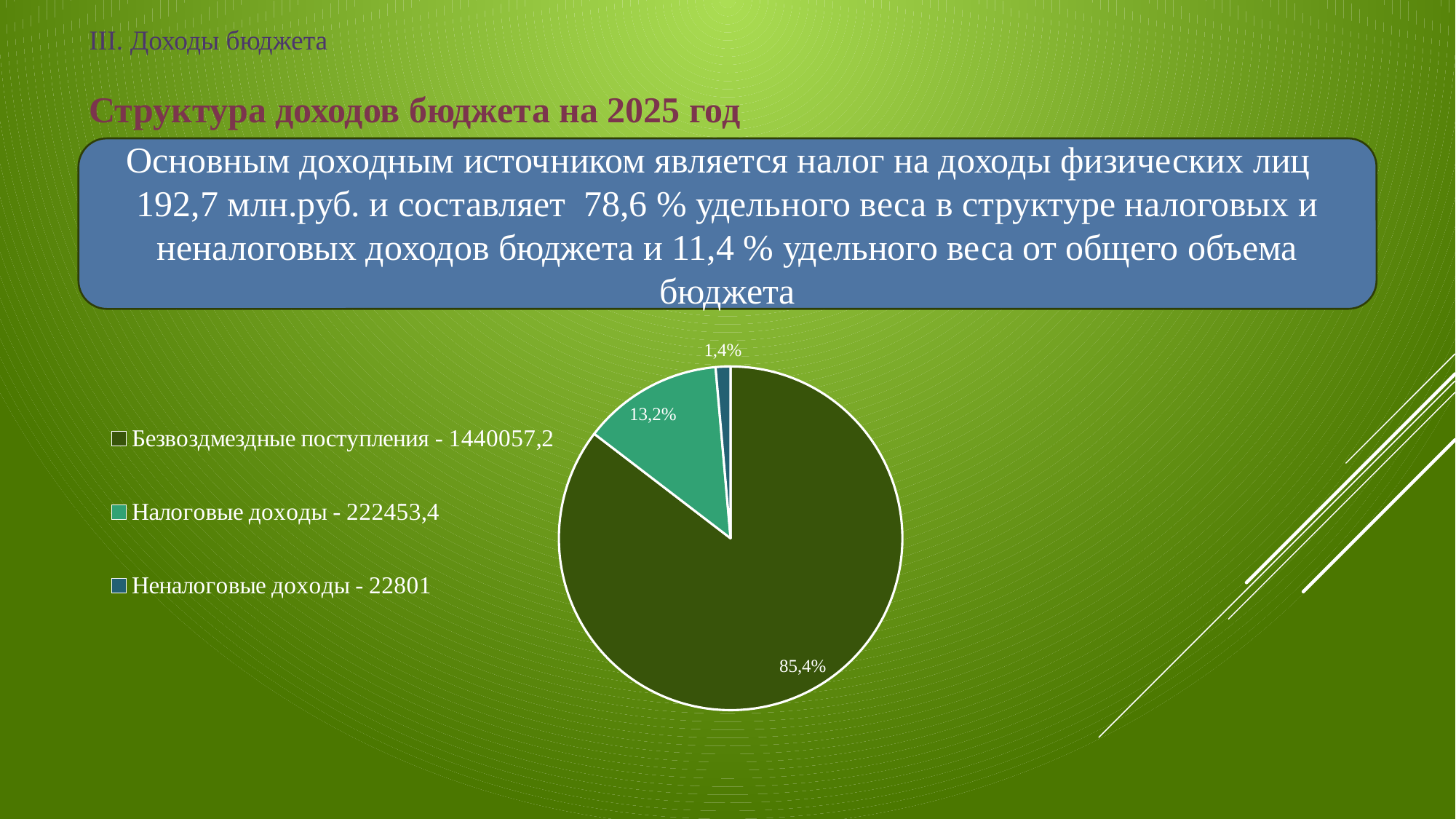
What share of the pie does Безвозмездные поступления take? 85,4% What value is given in the legend for Налоговые доходы? 222453,4 What share of the pie does Неналоговые доходы take? 1,4% Which category has the largest slice of the pie? Безвозмездные поступления What share of the pie does Налоговые доходы take? 13,2% Which category has the smallest slice of the pie? Неналоговые доходы How many slices does the pie chart have? 3 What kind of chart is shown on the slide? pie chart What value is given in the legend for Неналоговые доходы? 22801 What is the title of the chart section on the slide? Структура доходов бюджета на 2025 год What is the difference in percentage points between the shares of Налоговые доходы and Неналоговые доходы? 11,8 Which slice is larger: Налоговые доходы or Неналоговые доходы? Налоговые доходы